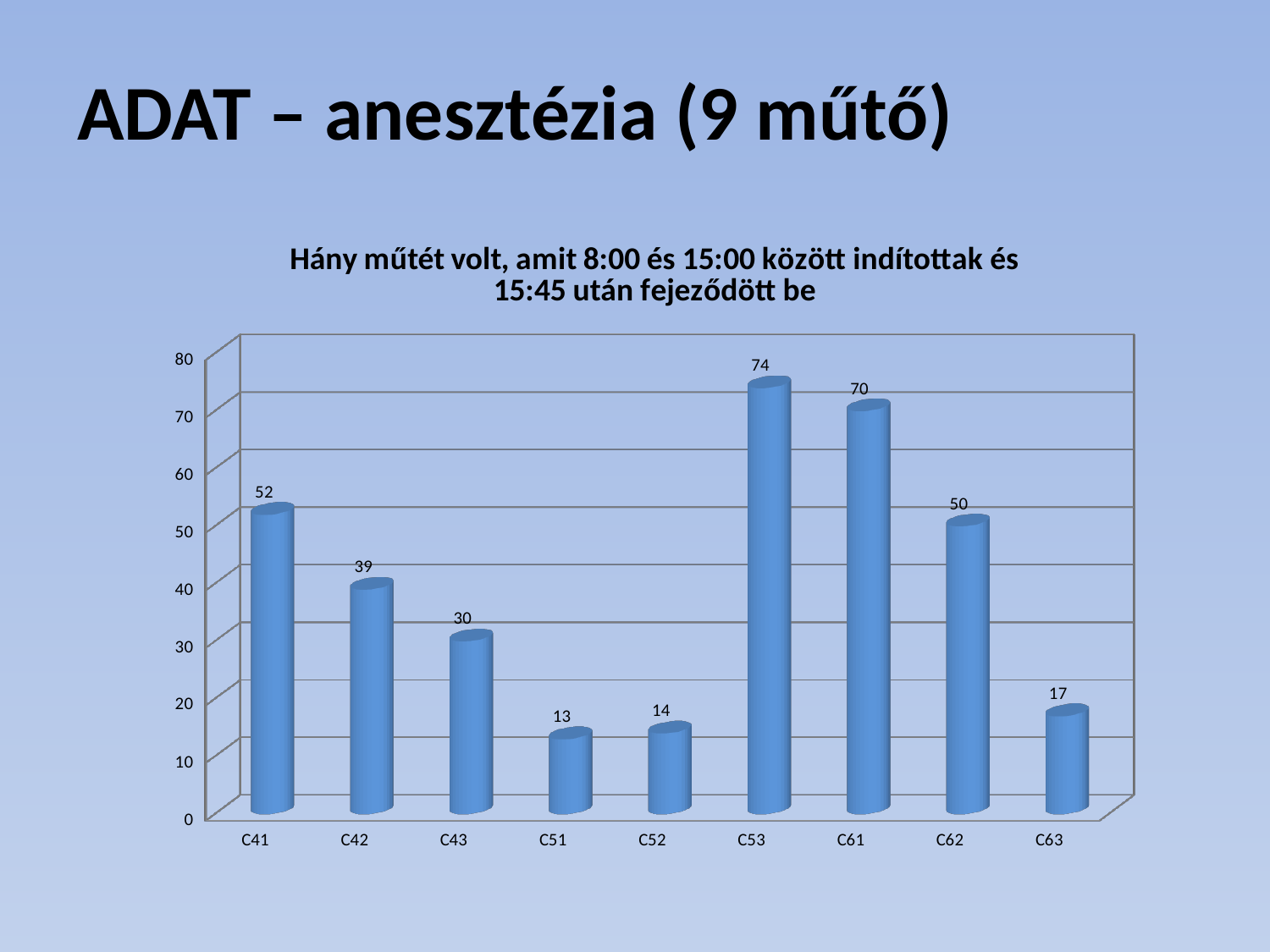
What is the title of the chart? Hány műtét volt, amit 8:00 és 15:00 között indítottak és 15:45 után fejeződött be What is the value for C63? 17 What is the value for C53? 74 What is the difference between the values for C41 and C43? 22 What is the value for C42? 39 What kind of chart is shown on the slide? bar chart Is the value for C61 greater or less than 60? greater Which category has the lowest value? C51 Which category has the highest value? C53 How many categories are shown on the x axis? 9 Which is larger, the value for C62 or the value for C41? C41 What is the difference between the values for C53 and C61? 4